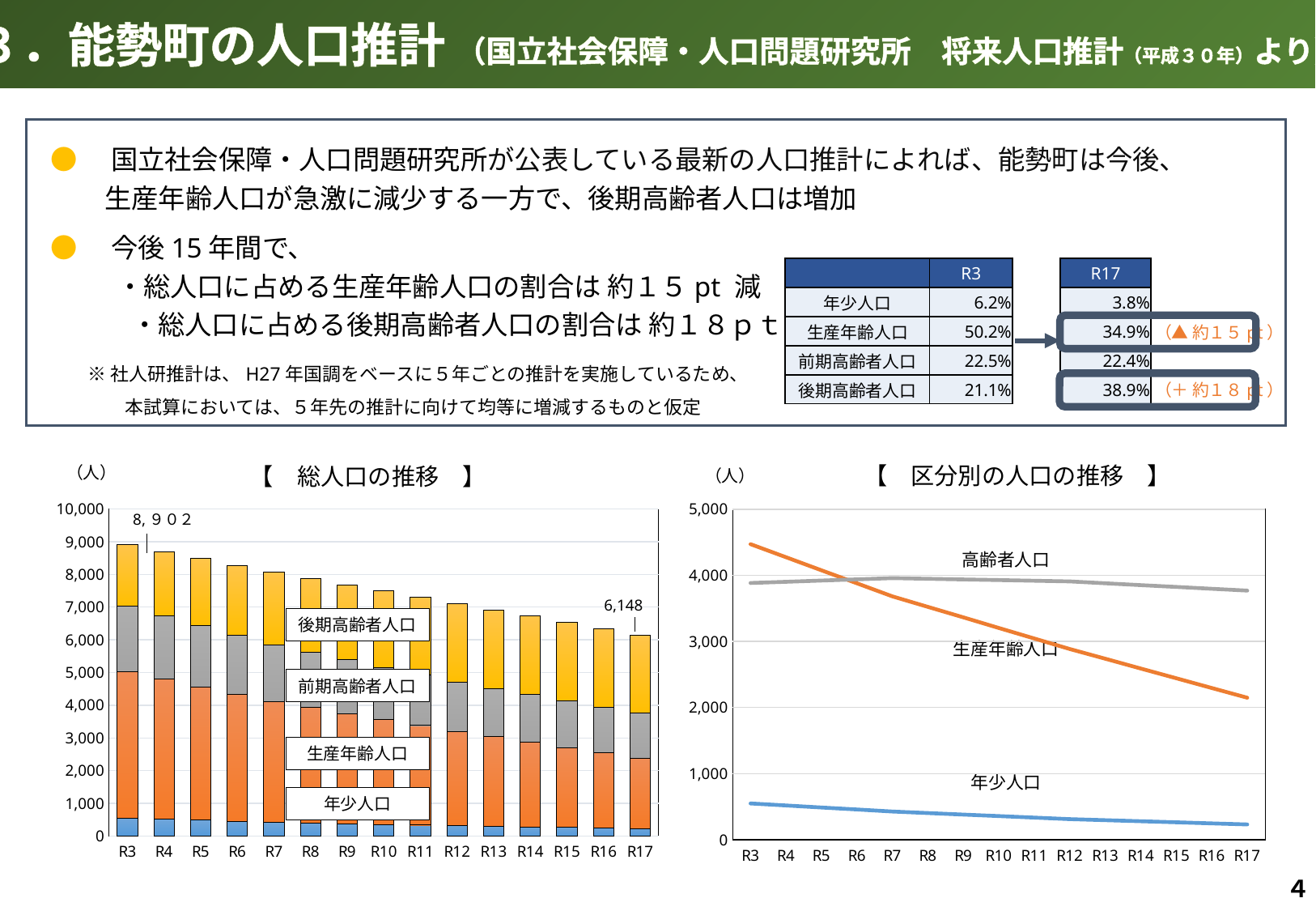
What kind of chart is the left chart titled 総人口の推移? bar chart In the left chart 総人口の推移, how many population segments make up each stacked bar? 4 In the left chart 総人口の推移, how many years are shown on the x axis? 15 In the right chart 区分別の人口の推移, does 生産年齢人口 rise or fall from R3 to R17? fall In the right chart 区分別の人口の推移, how many lines are plotted? 3 In the right chart 区分別の人口の推移, is the value for 生産年齢人口 at R3 greater or less than 4,000? greater In the left chart 総人口の推移, does the total population rise or fall from R3 to R17? fall In the left chart 総人口の推移, what is the total population labelled for R17? 6,148 What kind of chart is the right chart titled 区分別の人口の推移? line chart In the left chart 総人口の推移, what is the total population labelled for R3? 8,902 In the left chart 総人口の推移, what is the difference between the labelled totals for R3 and R17? 2,754 In the right chart 区分別の人口の推移, which category has the highest value at R17? 高齢者人口